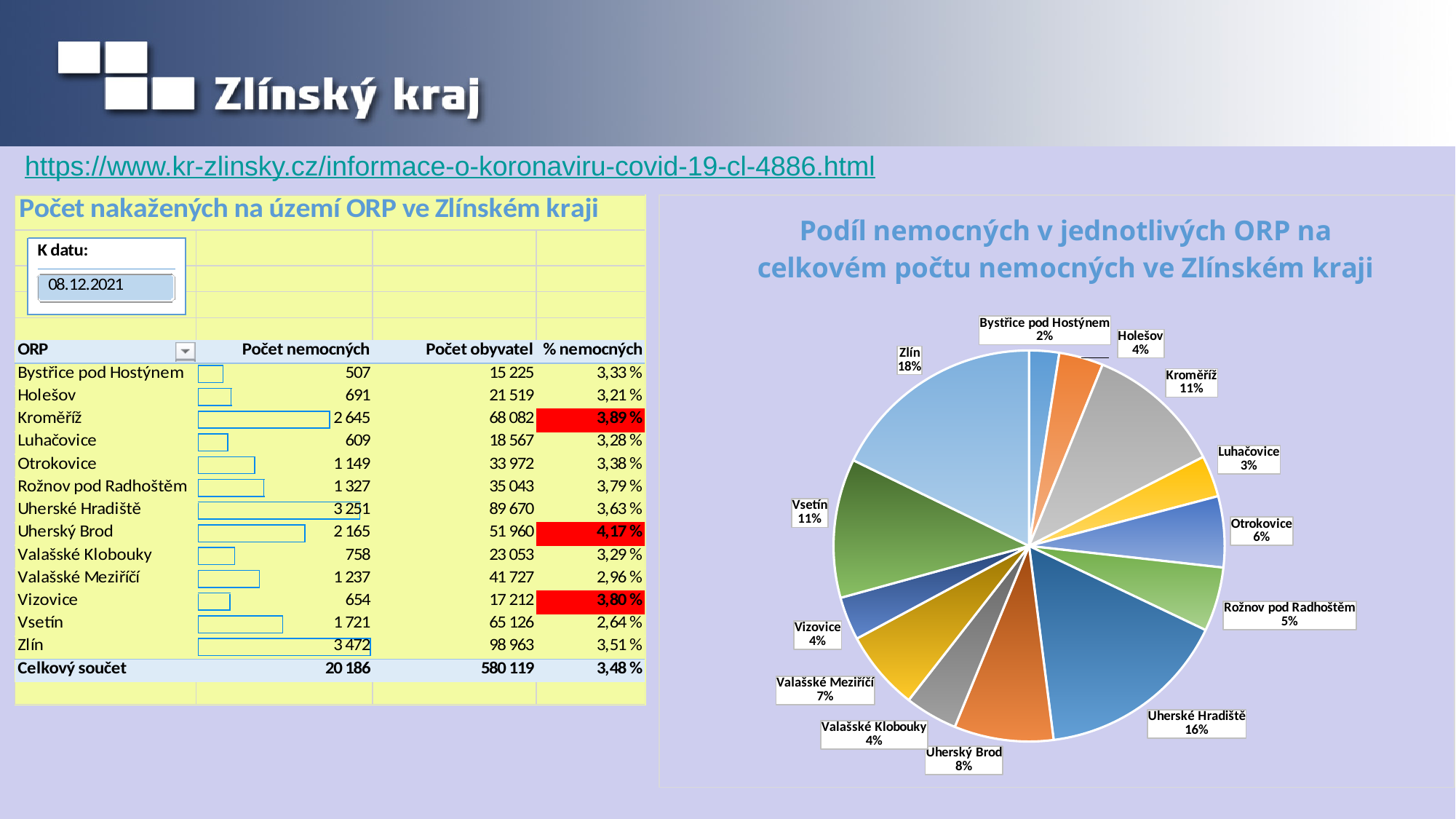
In the pie chart, which is larger: the slice for Uherský Brod or the slice for Otrokovice? Uherský Brod Which ORP has the smallest slice in the pie chart? Bystřice pod Hostýnem How many slices does the pie chart have? 13 In the pie chart, what is the percentage shown for Kroměříž? 11% What is the title of the pie chart? Podíl nemocných v jednotlivých ORP na celkovém počtu nemocných ve Zlínském kraji Which ORP has the largest slice in the pie chart? Zlín In the pie chart, what is the difference in percentage points between Zlín and Uherské Hradiště? 2 What share of the pie chart does Zlín have? 18% What kind of chart is shown on the right side of the slide? pie chart In the pie chart, what is the difference in percentage points between Vsetín and Rožnov pod Radhoštěm? 6 In the pie chart, what is the percentage shown for Valašské Meziříčí? 7% What share of the pie chart does Uherské Hradiště have? 16%